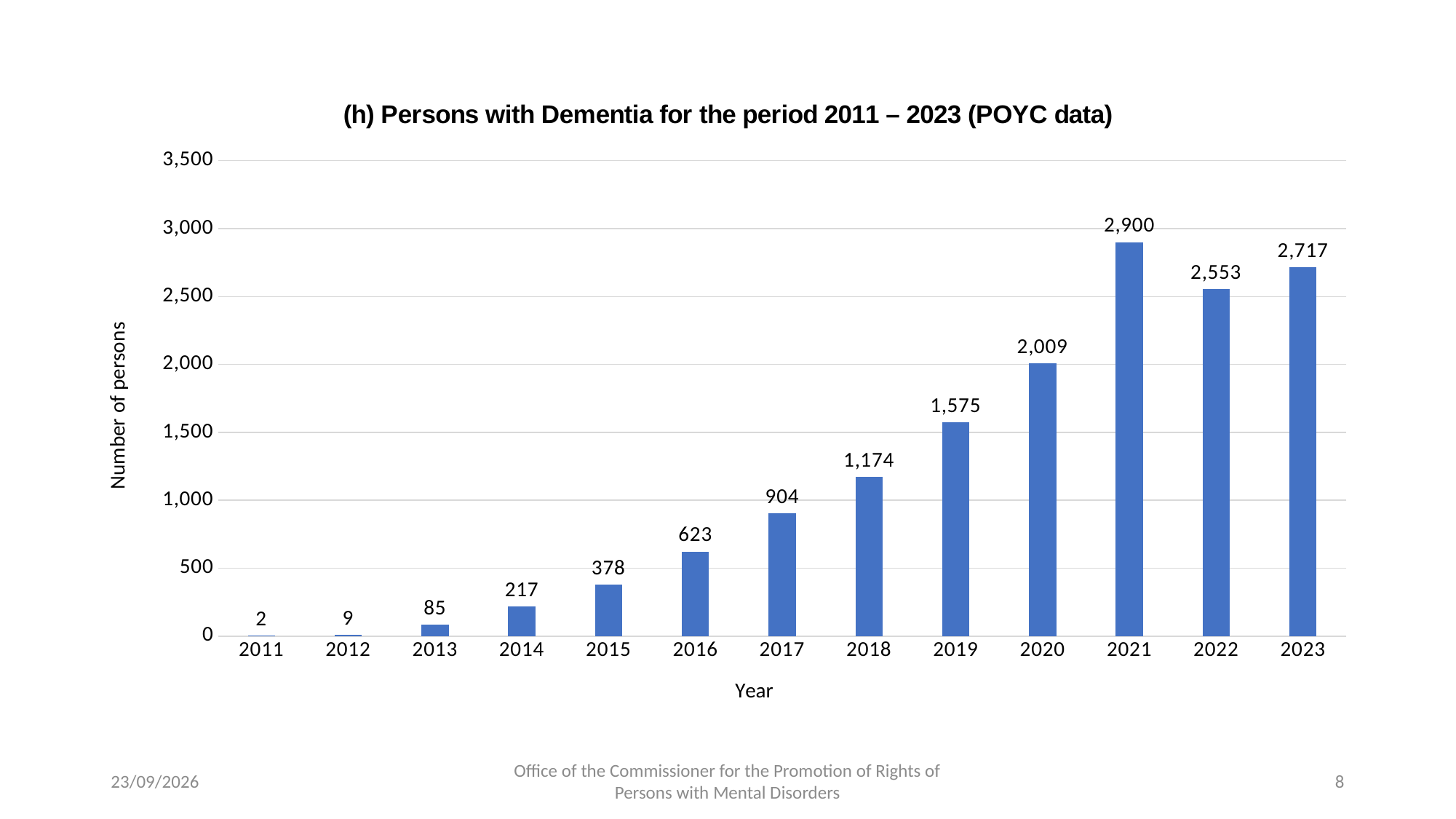
What is the label of the y axis? Number of persons How many years are shown on the x axis? 13 Which year has more persons with dementia, 2022 or 2023? 2023 What is the difference between the number of persons in 2021 and in 2022? 347 What is the number of persons with dementia in 2016? 623 What kind of chart is shown on the slide? Bar chart What is the number of persons with dementia in 2023? 2,717 Which year has the lowest number of persons with dementia? 2011 What is the number of persons with dementia in 2021? 2,900 Do the values generally rise or fall from 2011 to 2021? Rise Is the value for 2019 greater or less than 1,500? greater Which year has the highest number of persons with dementia? 2021